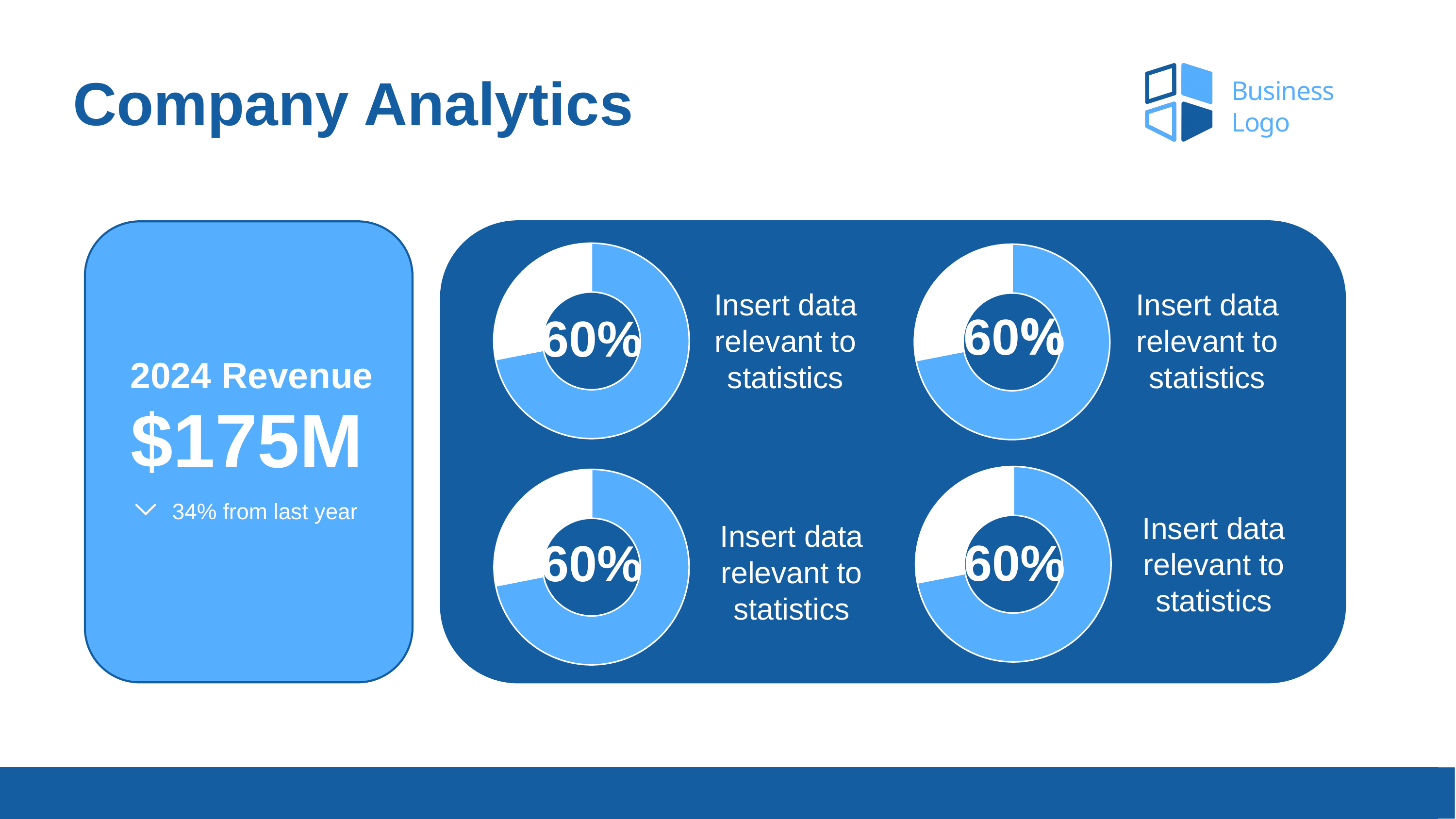
What percentage is shown in the centre of the bottom-left donut chart? 60% In the bottom-right donut chart, is the light blue filled portion greater or less than 50%? greater Do the four donut charts all show the same percentage value? Yes What placeholder text appears next to each donut chart? Insert data relevant to statistics What percentage is shown in the centre of the top-right donut chart? 60% What colour is the filled portion of the donut charts? Light blue In the top-right donut chart, is the white (unfilled) portion greater or less than 50%? less What percentage is shown in the centre of the bottom-right donut chart? 60% What kind of chart is used in the dark blue panel on the right of the slide? Donut chart How many donut charts are shown on the slide? 4 What percentage is shown in the centre of the top-left donut chart? 60%